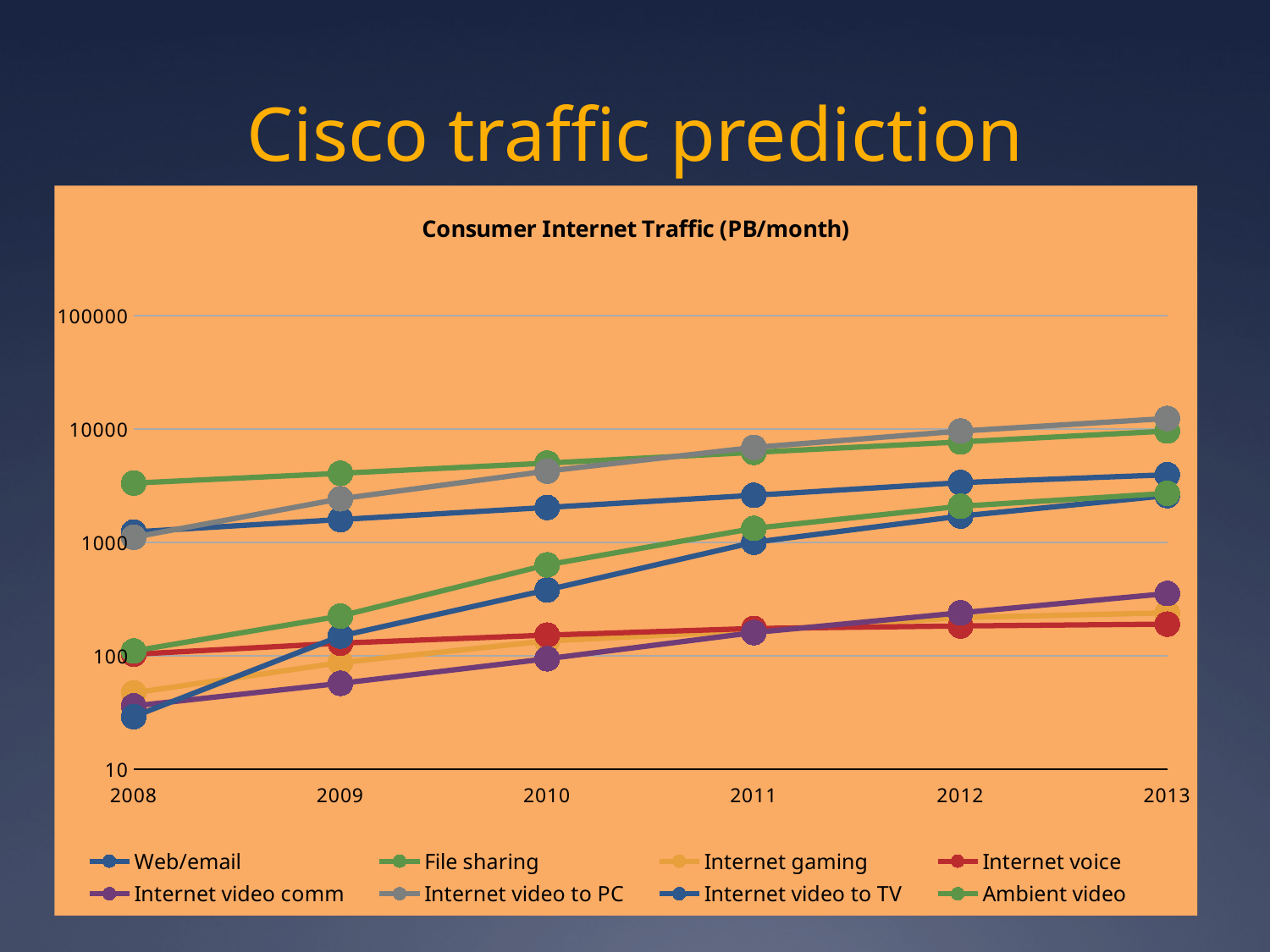
Is the value for Internet video to PC in 2011 greater or less than 10000? less Is the value for Internet video comm in 2008 greater or less than 100? less Which series has the highest value in 2013? Internet video to PC What is the title of the chart? Consumer Internet Traffic (PB/month) How many series does the legend list? 8 In 2013, which is larger: Internet video comm or Internet gaming? Internet video comm What kind of chart is shown on the slide? Line chart In 2012, which is larger: Internet video to PC or Internet voice? Internet video to PC Is the value for Internet video to PC in 2013 greater or less than 10000? greater Which series has the lowest value in 2013? Internet voice Does the Internet video comm series rise or fall from 2008 to 2013? Rises How many years are shown along the x axis? 6